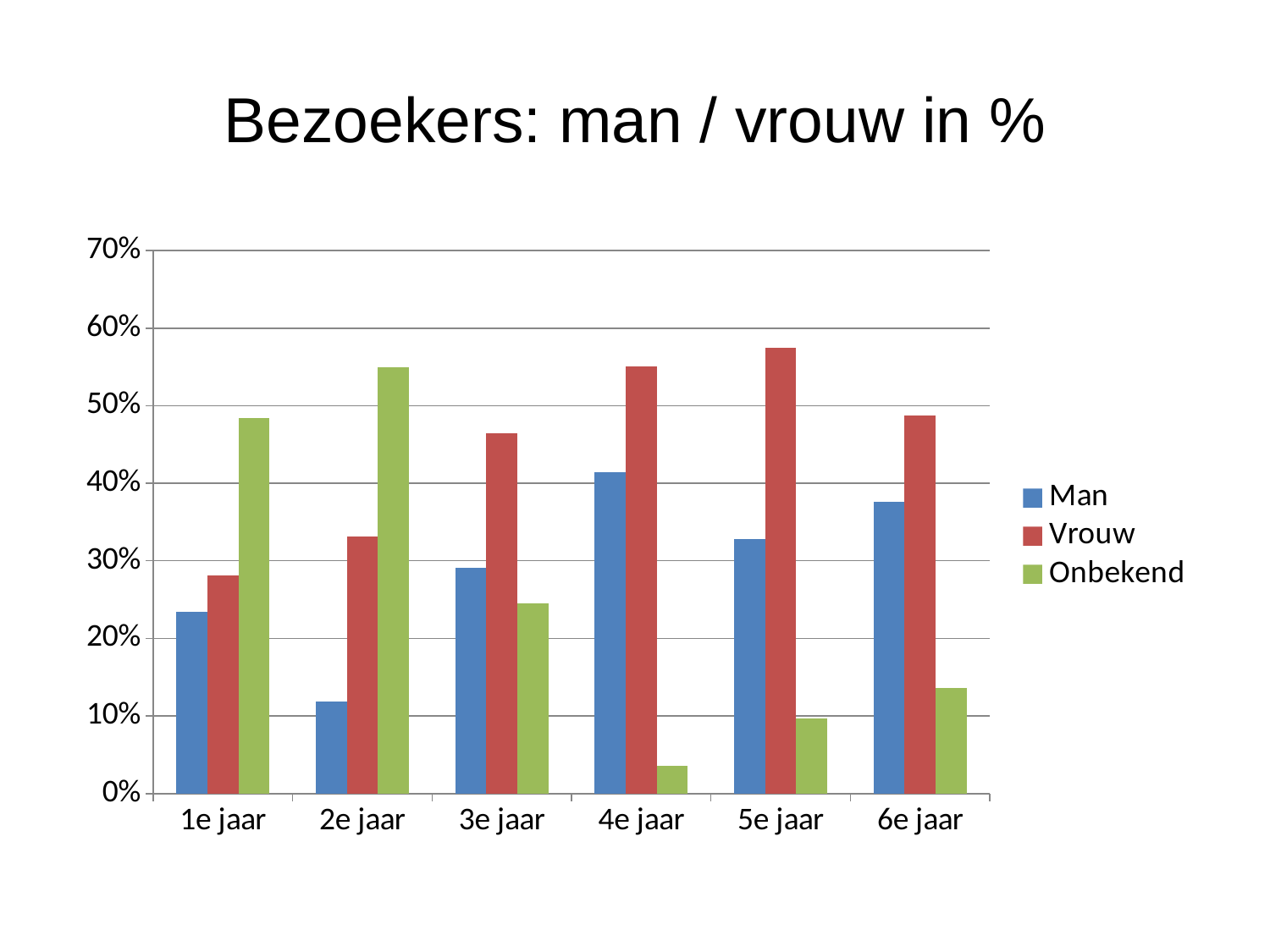
Is the value for Vrouw in 5e jaar greater or less than 50%? greater In which year is the value for Onbekend the lowest? 4e jaar In which year is the value for Man the highest? 4e jaar Is the value for Man in 2e jaar greater or less than 20%? less What is the title of the chart? Bezoekers: man / vrouw in % How many year categories are shown on the x axis? 6 In 6e jaar, which is larger: Man or Onbekend? Man In which year is the value for Onbekend the highest? 2e jaar In which year is the value for Man the lowest? 2e jaar How many series does the legend list? 3 In 1e jaar, which is larger: Man or Vrouw? Vrouw What kind of chart is shown on the slide? bar chart